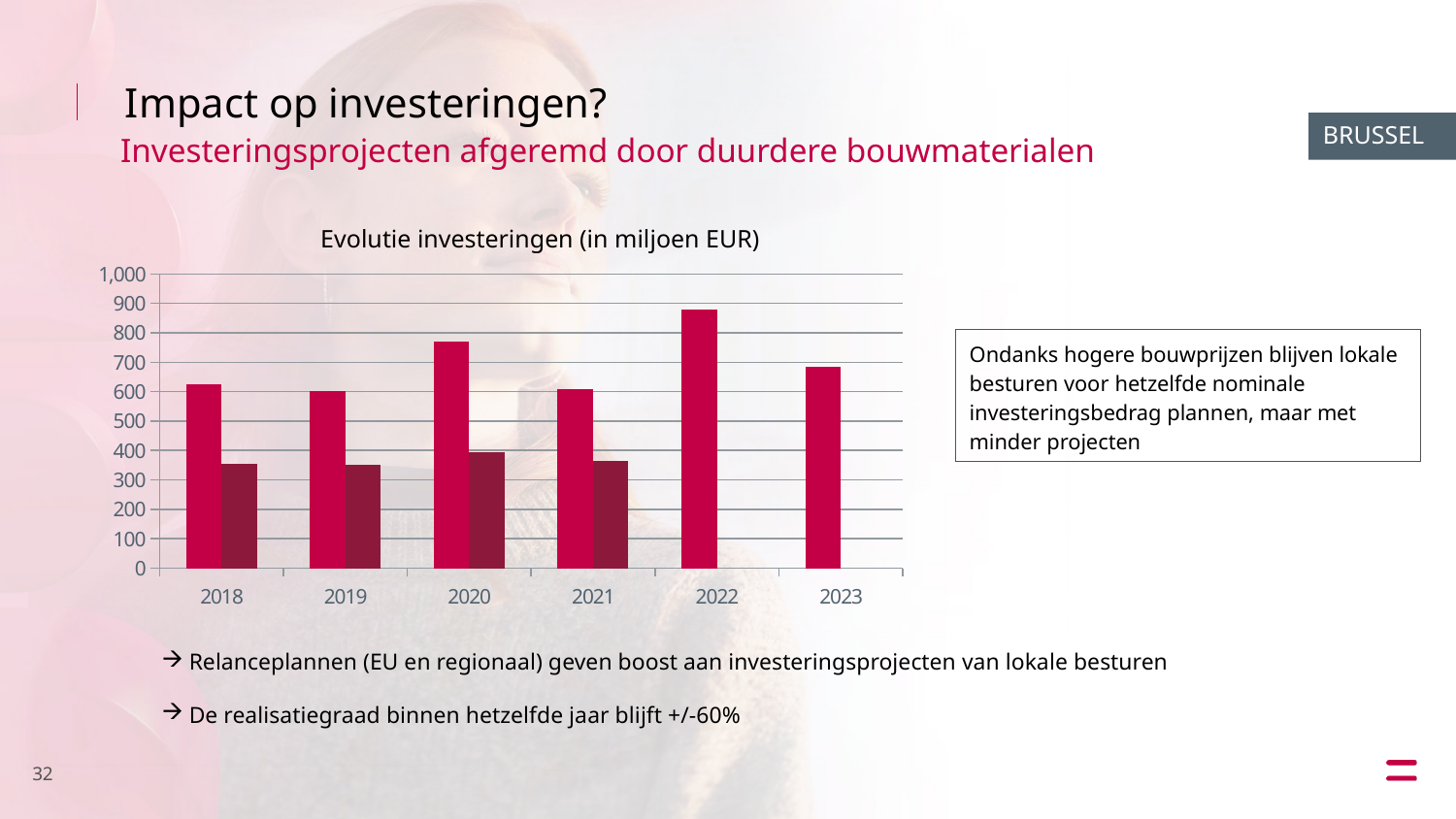
How many years are shown on the x axis of the chart? 6 Is the bright red bar for 2020 greater or less than 700? greater Which year has the larger bright red bar, 2022 or 2023? 2022 Which year has the tallest dark red bar? 2020 Which year has the larger bright red bar, 2020 or 2021? 2020 How many years in the chart have both a bright red and a dark red bar? 4 Is the bright red bar for 2023 greater or less than 600? greater What kind of chart is shown on the slide? bar chart Which year has the tallest bright red bar? 2022 Is the bright red bar for 2022 greater or less than 800? greater What is the title of the chart? Evolutie investeringen (in miljoen EUR)